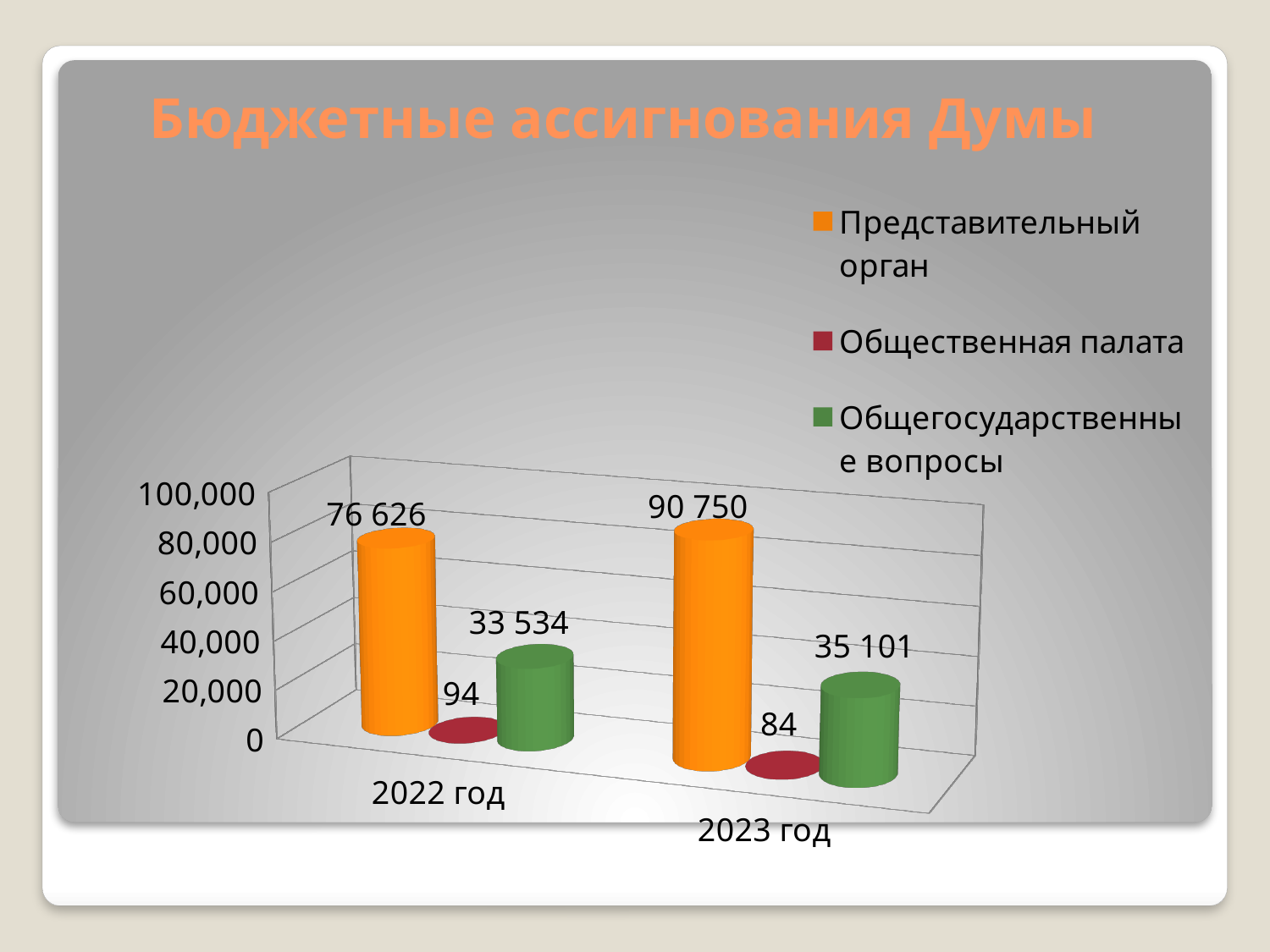
What is the value for Общегосударственные вопросы in 2023 год? 35 101 Which series has the lowest value in 2022 год? Общественная палата What kind of chart is shown on the slide? Bar chart How many series does the legend list? 3 What is the title of the chart? Бюджетные ассигнования Думы What is the difference between the Представительный орган values for 2023 год and 2022 год? 14 124 Which is larger: Общегосударственные вопросы in 2022 год or in 2023 год? 2023 год Which series has the highest value in 2023 год? Представительный орган What is the value for Представительный орган in 2023 год? 90 750 What is the value for Представительный орган in 2022 год? 76 626 How many categories are shown on the x axis? 2 What is the value for Общественная палата in 2022 год? 94